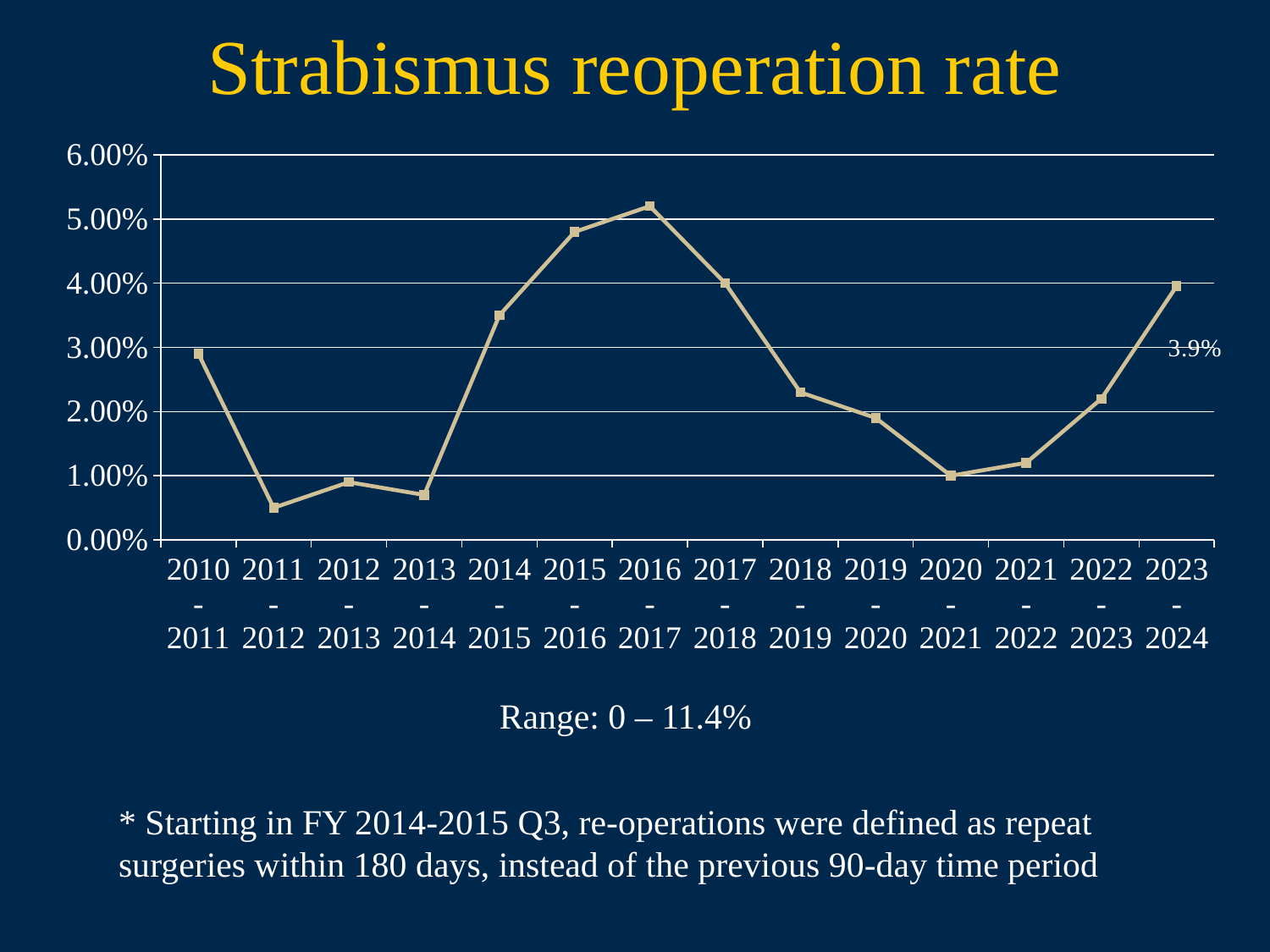
Is the value for 2011-2012 greater or less than 1.00%? less What is the reoperation rate for 2023-2024? 3.9% How many periods are plotted on the chart? 14 Which period has the lowest reoperation rate? 2011-2012 Which period has the highest reoperation rate? 2016-2017 Is the value for 2014-2015 greater or less than 3.00%? greater What is the title of the chart? Strabismus reoperation rate Does the reoperation rate rise or fall from 2016-2017 to 2020-2021? Fall What range is stated below the chart? 0 – 11.4% What type of chart is shown on the slide? Line chart Which is larger, the value for 2015-2016 or the value for 2018-2019? 2015-2016 Is the value for 2015-2016 greater or less than 4.00%? greater